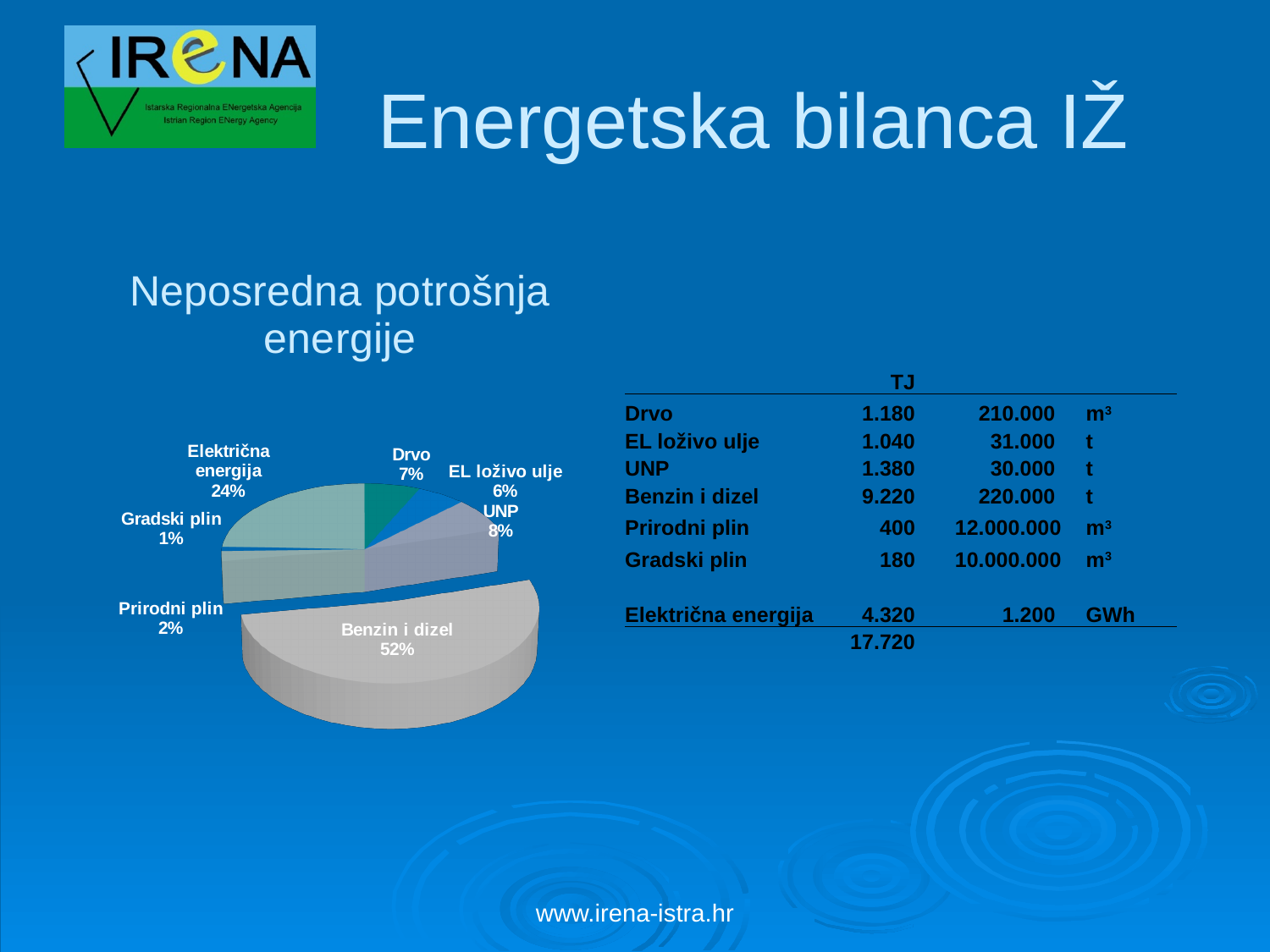
What is the difference in percentage points between Benzin i dizel and Električna energija? 28 What is the value shown for UNP in the pie chart? 8% What kind of chart is shown on the slide? pie chart What is the value shown for Drvo in the pie chart? 7% What share of the pie does Električna energija have? 24% What is the value shown for Gradski plin in the pie chart? 1% What share of the pie does Benzin i dizel have? 52% Which is larger in the pie chart, UNP or EL loživo ulje? UNP Which category has the largest slice of the pie? Benzin i dizel How many slices does the pie chart have? 7 What is the title of the pie chart? Neposredna potrošnja energije Which category has the smallest slice of the pie? Gradski plin